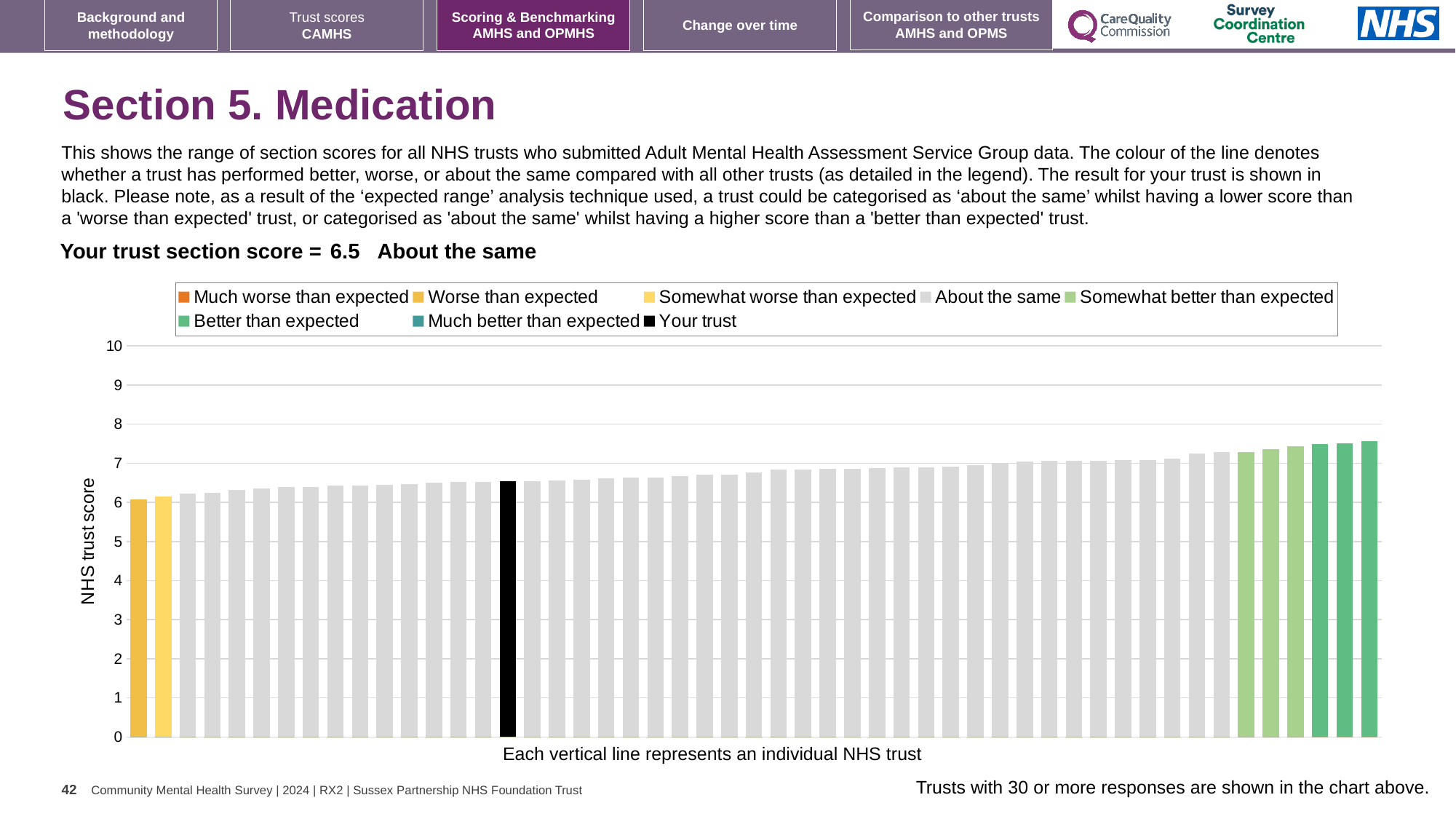
What colour is the bar representing your trust? black What is the title of the vertical axis? NHS trust score Is the value for your trust greater or less than 7? less How many bars in the chart are coloured yellow or orange (worse than expected categories)? 2 Is the value of the tallest bar in the chart greater or less than 7? greater Do the bar values rise or fall from left to right along the x axis? rise What kind of chart is shown on the slide? bar chart How many entries does the chart legend list? 8 What is the section score for your trust shown on the slide? 6.5 Is the value for your trust greater or less than 6? greater How many bars in the chart are coloured green (somewhat better, better or much better than expected)? 6